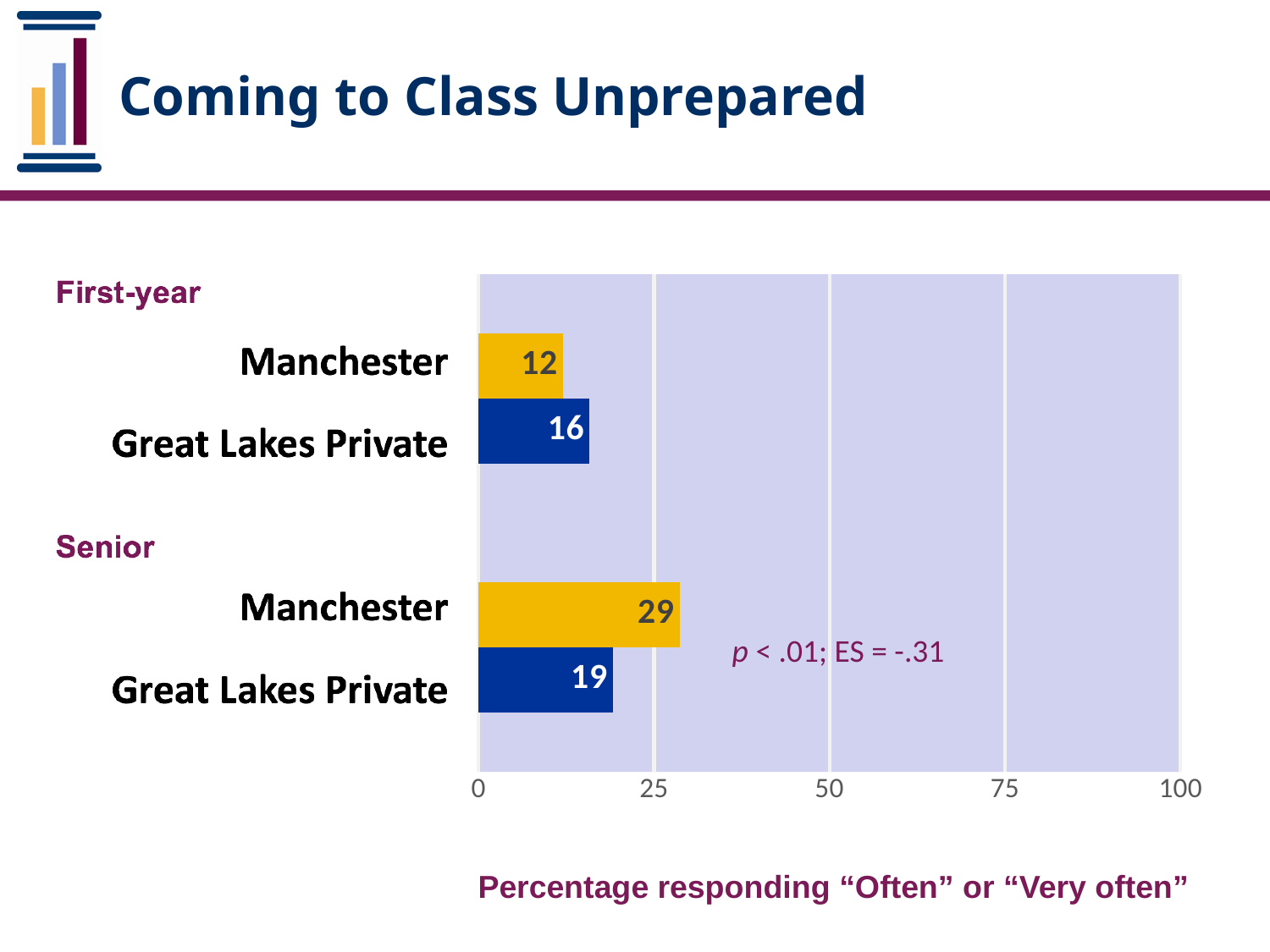
Which bar has the lowest value? First-year Manchester What is the value for First-year Manchester? 12 What is the value for Senior Manchester? 29 What is the value for Senior Great Lakes Private? 19 Is the value for Senior Manchester greater or less than 25? greater How many bars are plotted on the chart? 4 What is the difference between First-year Great Lakes Private and First-year Manchester? 4 What is the difference between Senior Manchester and Senior Great Lakes Private? 10 Which bar has the highest value? Senior Manchester What kind of chart is shown on the slide? bar chart What is the value for First-year Great Lakes Private? 16 Which is larger, First-year Manchester or First-year Great Lakes Private? First-year Great Lakes Private